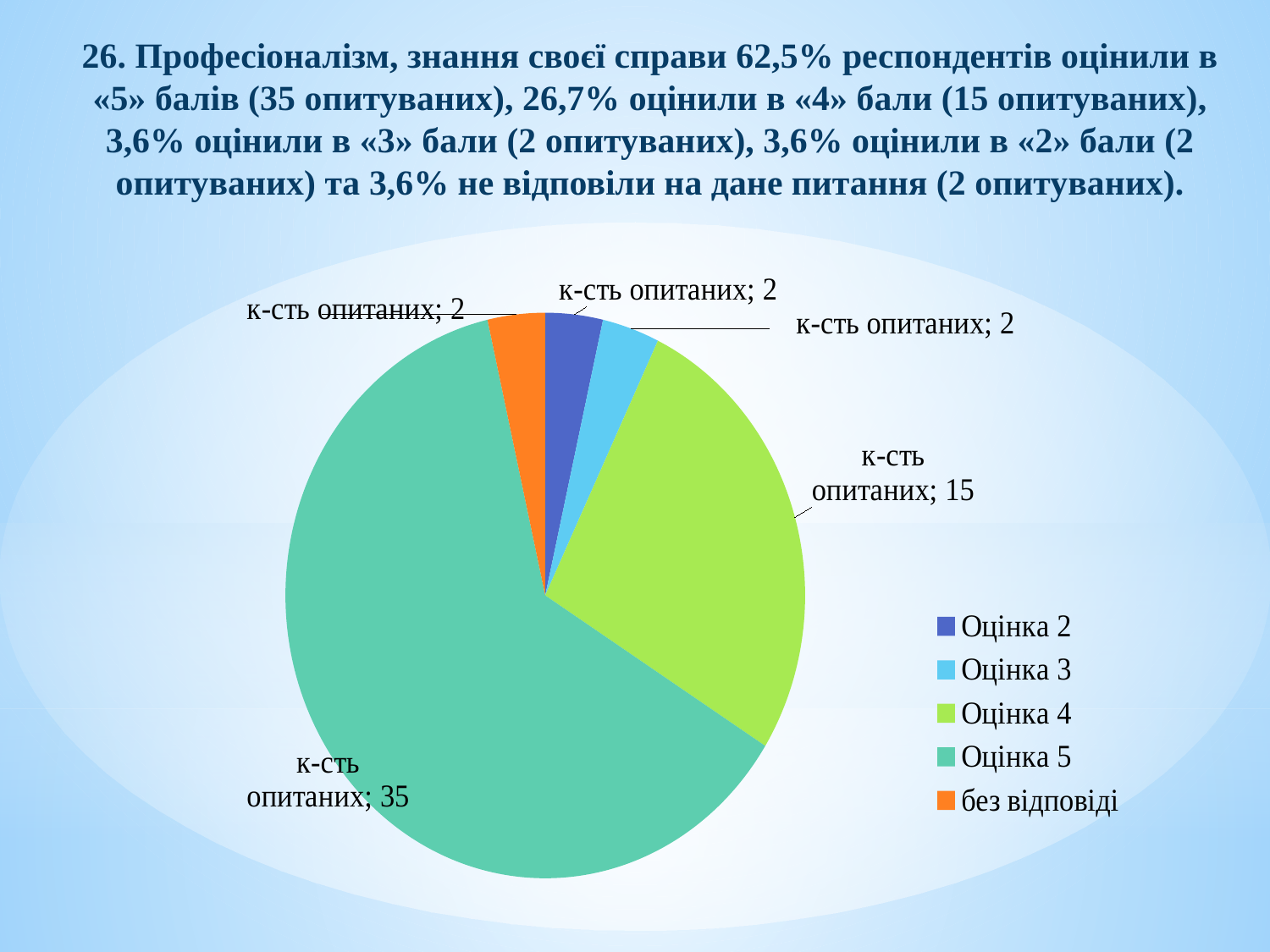
What is the total of all values in the pie chart? 56 Which category has the largest slice in the pie chart? Оцінка 5 What is the difference between the values for Оцінка 5 and Оцінка 4 in the pie chart? 20 How many respondents are shown for без відповіді in the pie chart? 2 How many respondents are shown for Оцінка 5 in the pie chart? 35 How many respondents are shown for Оцінка 3 in the pie chart? 2 How many respondents are shown for Оцінка 4 in the pie chart? 15 What share of the pie does Оцінка 5 represent? 62,5% What type of chart is shown on the slide? pie chart Which is larger in the pie chart, Оцінка 4 or Оцінка 5? Оцінка 5 How many slices does the pie chart have? 5 What colour is the slice for без відповіді in the pie chart? orange